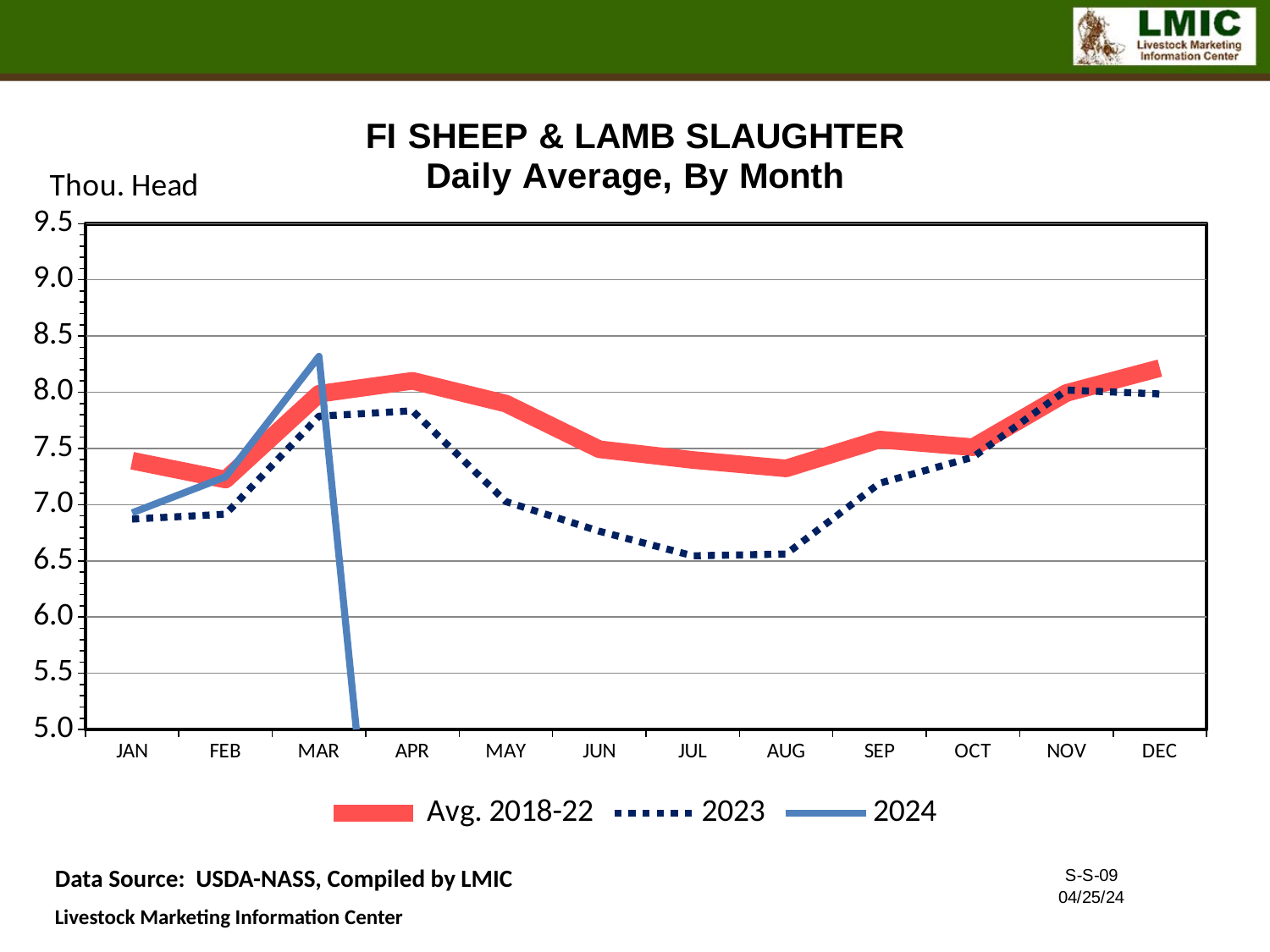
Does the 2023 series rise or fall from APR to JUL? fall How many months are shown along the x axis? 12 Is the Avg. 2018-22 value for DEC greater or less than 8.0? greater In JUL, which is larger: the Avg. 2018-22 value or the 2023 value? Avg. 2018-22 What kind of chart is shown on the slide? line chart How many series does the legend list? 3 Is the 2023 value for JUL greater or less than 7.0? less Which series are listed in the legend? Avg. 2018-22, 2023, 2024 Is the 2023 value for APR greater or less than 7.5? greater What is the unit label shown on the y axis? Thou. Head In which month does the 2024 series reach its highest value? MAR